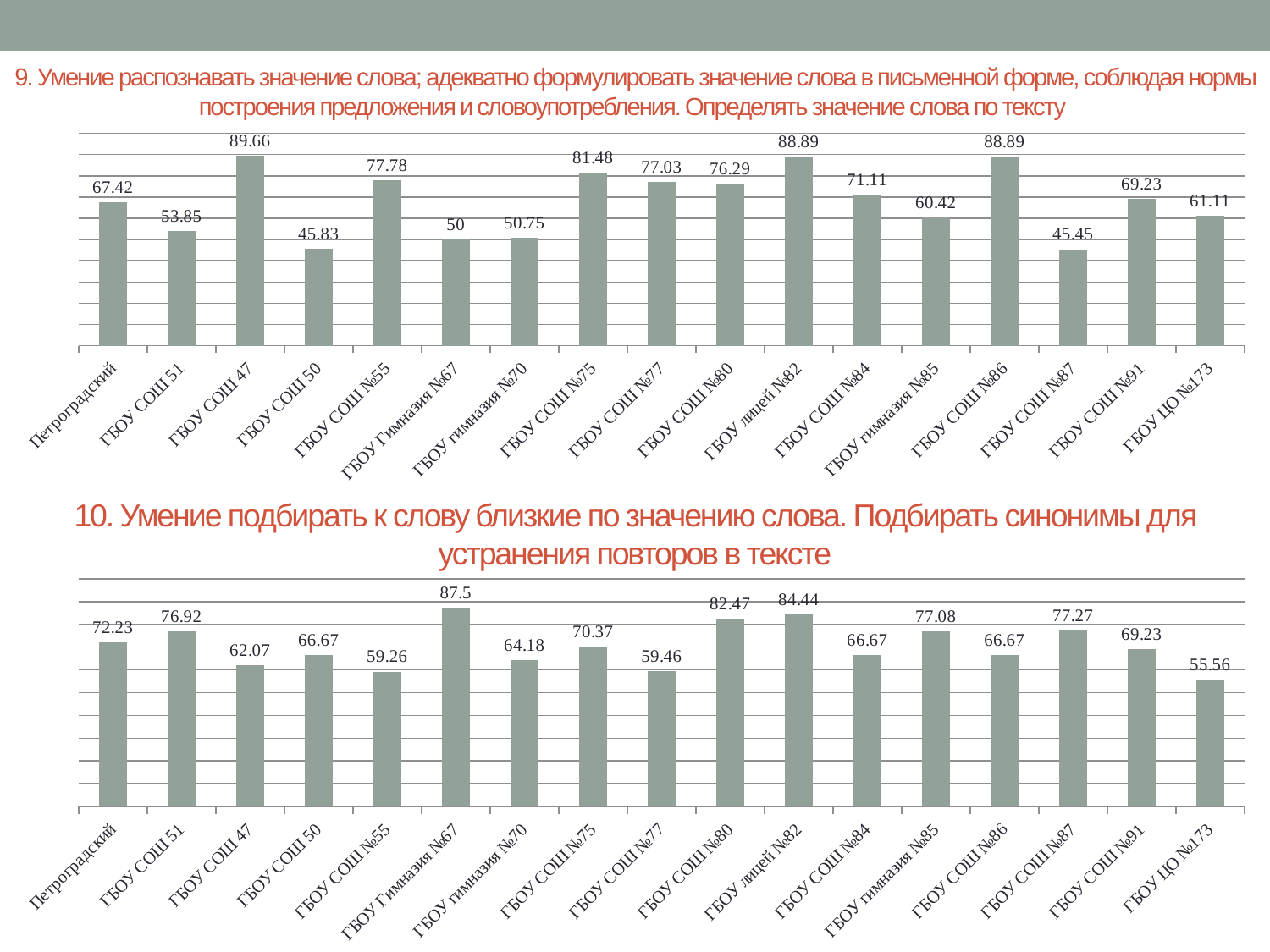
In the bottom chart (skill 10), what is the value for ГБОУ Гимназия №67? 87.5 In the top chart (skill 9), which school has the lowest value? ГБОУ СОШ №87 In the top chart (skill 9), how many schools/categories are plotted? 17 In the bottom chart (skill 10), what is the difference between the values for ГБОУ СОШ №87 and ГБОУ СОШ №86? 10.6 In the top chart (skill 9), what is the value for ГБОУ СОШ 47? 89.66 What type of chart is the bottom chart (skill 10)? Bar chart In the bottom chart (skill 10), which school has the lowest value? ГБОУ ЦО №173 In the bottom chart (skill 10), what is the value for Петроградский? 72.23 In the bottom chart (skill 10), which is larger: the value for ГБОУ СОШ №80 or ГБОУ лицей №82? ГБОУ лицей №82 In the top chart (skill 9), which school has the highest value? ГБОУ СОШ 47 In the top chart (skill 9), what is the difference between the values for ГБОУ СОШ №75 and ГБОУ СОШ 50? 35.65 In the top chart (skill 9), what is the value for ГБОУ гимназия №85? 60.42